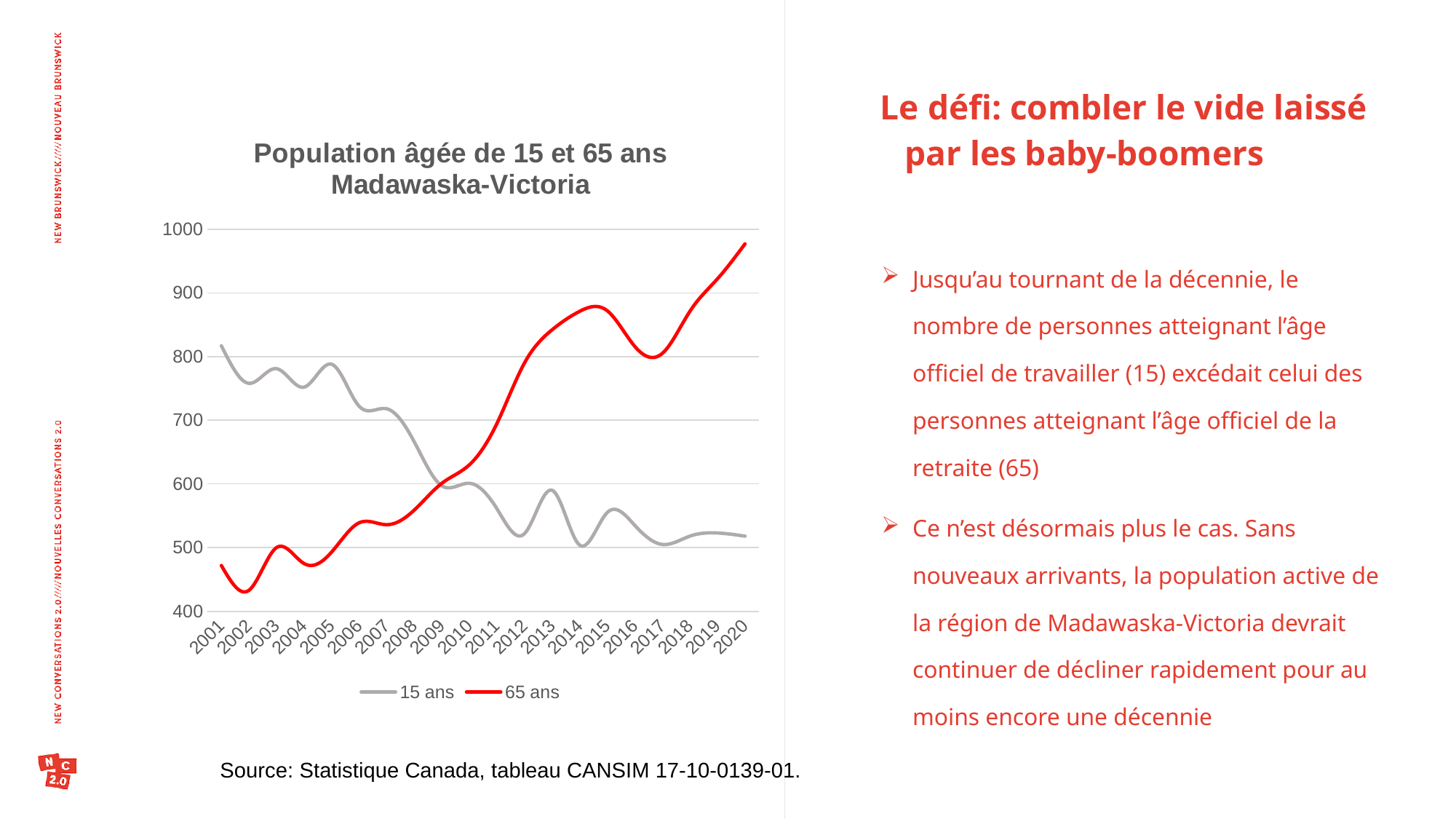
In 2001, which series has the higher value, '15 ans' or '65 ans'? 15 ans Is the value for '15 ans' in 2020 greater or less than 600? less What colour is the line for the '65 ans' series? red Is the value for '65 ans' in 2020 greater or less than 900? greater Does the '65 ans' series generally rise or fall from 2001 to 2020? rise Does the '15 ans' series generally rise or fall from 2001 to 2020? fall What kind of chart is shown on the slide? line chart Is the value for '65 ans' in 2002 greater or less than 500? less In 2020, which series has the higher value, '15 ans' or '65 ans'? 65 ans How many years are shown on the x axis of the chart? 20 How many series does the legend of the chart list? 2 In which year does the '65 ans' series reach its highest value? 2020